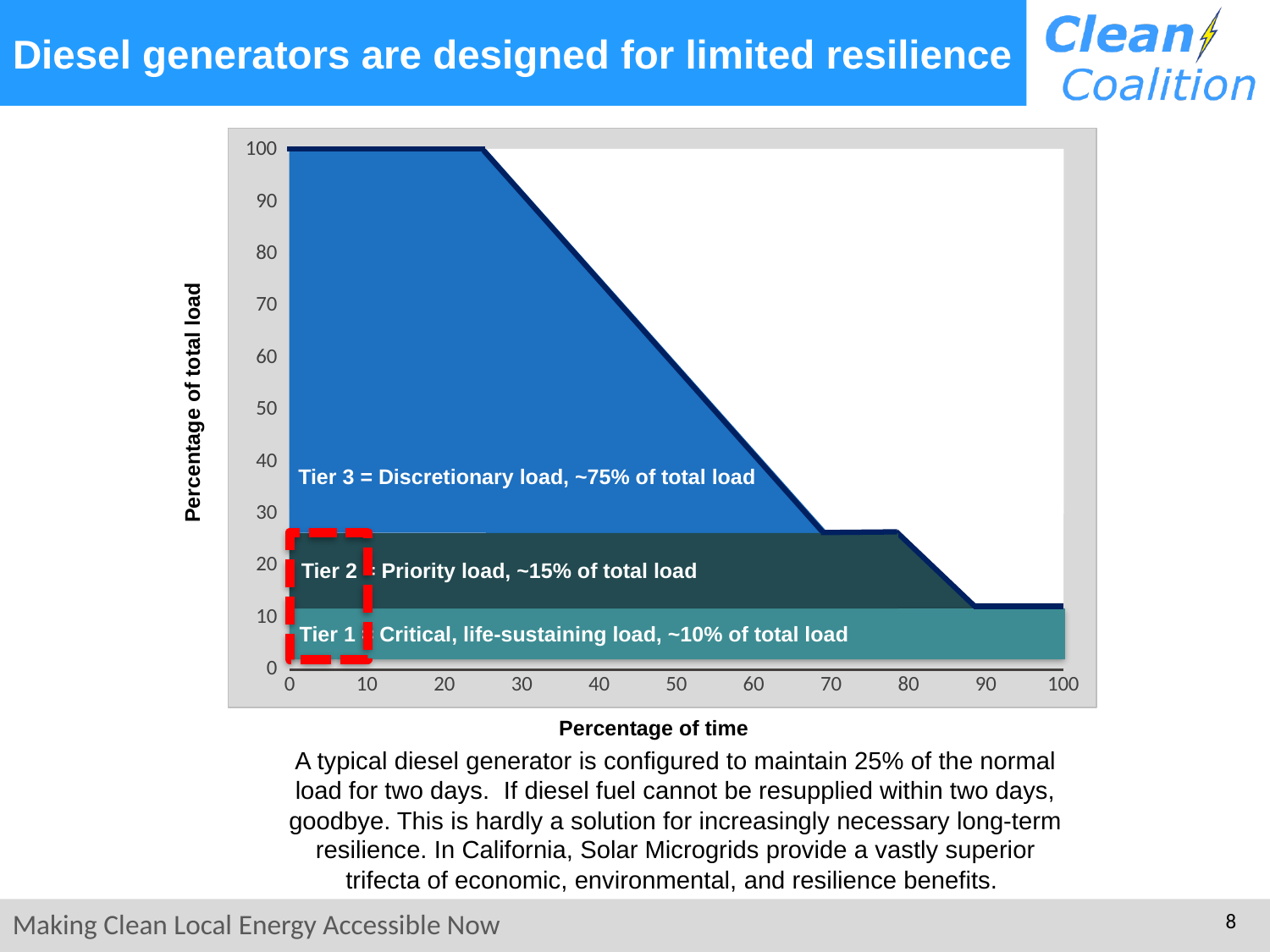
Is the percentage of total load at 75% of time greater or less than 30? less How many load tiers are labelled on the chart? 3 Is the percentage of total load at 95% of time greater or less than 20? less Does the percentage of total load rise or fall as the percentage of time increases? fall Is the percentage of total load at 50% of time greater or less than 50? greater According to the chart label, what share of total load is Tier 3 (Discretionary load)? ~75% of total load What kind of chart is shown on the slide? area chart What is the title of the x axis? Percentage of time What is the title of the y axis? Percentage of total load What is the percentage of total load at 0% of time? 100